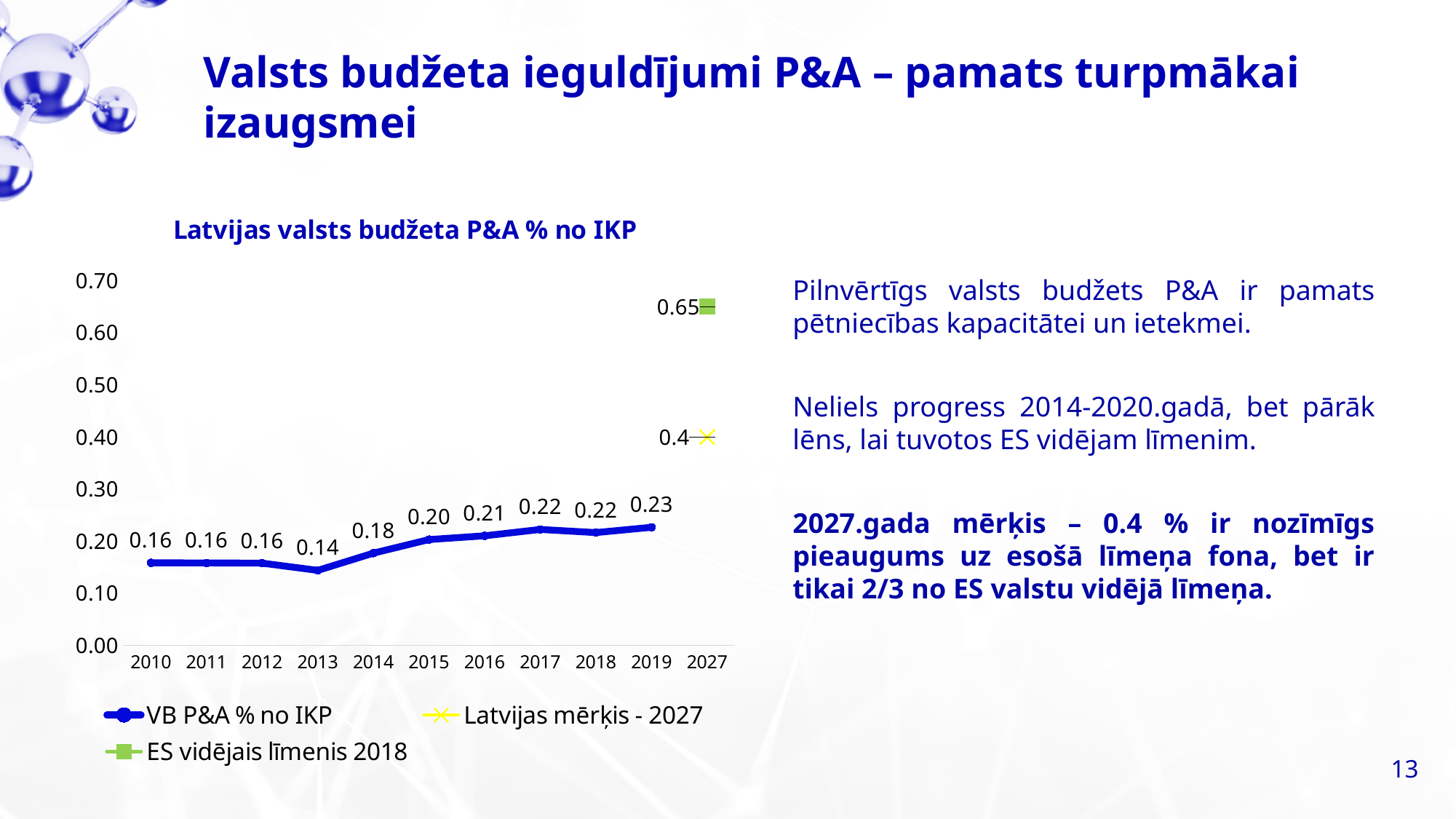
What kind of chart is shown on the slide? Line chart In which year is the VB P&A % no IKP series highest? 2019 What is the difference between the VB P&A % no IKP values for 2019 and 2010? 0.07 What is the value of VB P&A % no IKP for 2013? 0.14 What is the difference between the ES vidējais līmenis 2018 value and the Latvijas mērķis - 2027 value? 0.25 In which year is the VB P&A % no IKP series lowest? 2013 How many series does the legend list? 3 Which is larger, the VB P&A % no IKP value for 2015 or for 2013? 2015 What value is shown for ES vidējais līmenis 2018? 0.65 What is the value of VB P&A % no IKP for 2019? 0.23 What is the title of the chart? Latvijas valsts budžeta P&A % no IKP What value is shown for Latvijas mērķis - 2027? 0.4